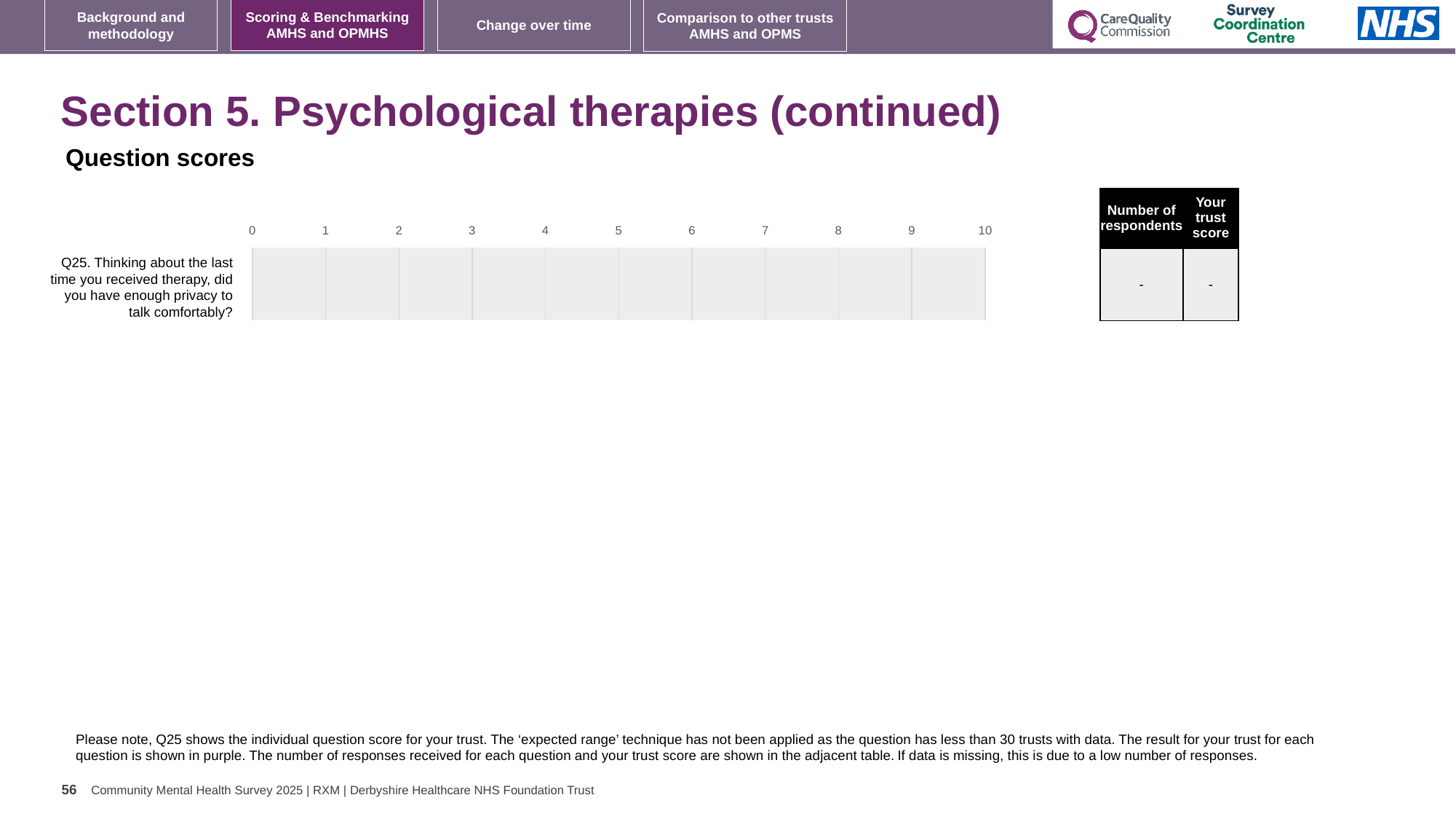
What is the trust score shown in the table for Q25? - What is the highest value shown on the x axis of the Question scores chart? 10 What is the heading above the chart on this slide? Question scores What is the number of respondents shown in the table for Q25? - Is a bar plotted for Q25 on the Question scores chart? No What is the lowest value shown on the x axis of the Question scores chart? 0 How many questions are listed on the Question scores chart? 1